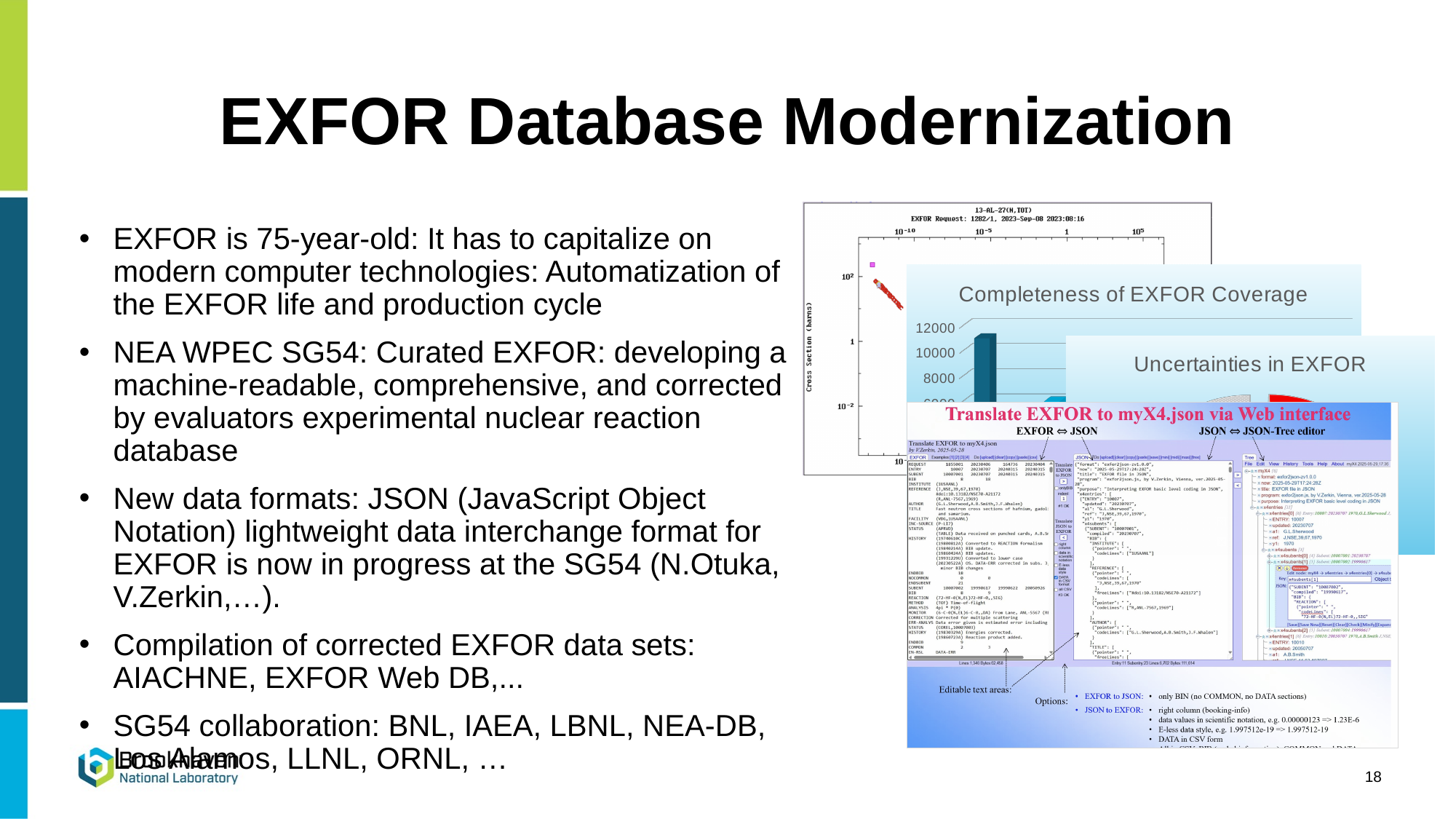
In the 'Completeness of EXFOR Coverage' chart, is the value of the leftmost bar greater or less than 10000? greater What is the title of the chart partially visible behind the web-interface screenshot, to the right of the bar chart? Uncertainties in EXFOR What kind of chart is the 'Completeness of EXFOR Coverage' chart? bar chart What reaction is named in the title of the cross-section plot in the top right of the slide? 13-AL-27(N,TOT) In the 'Completeness of EXFOR Coverage' chart, is the value of the leftmost bar greater or less than 12000? less What is the y-axis label of the cross-section plot in the top right of the slide? Cross Section (barns)